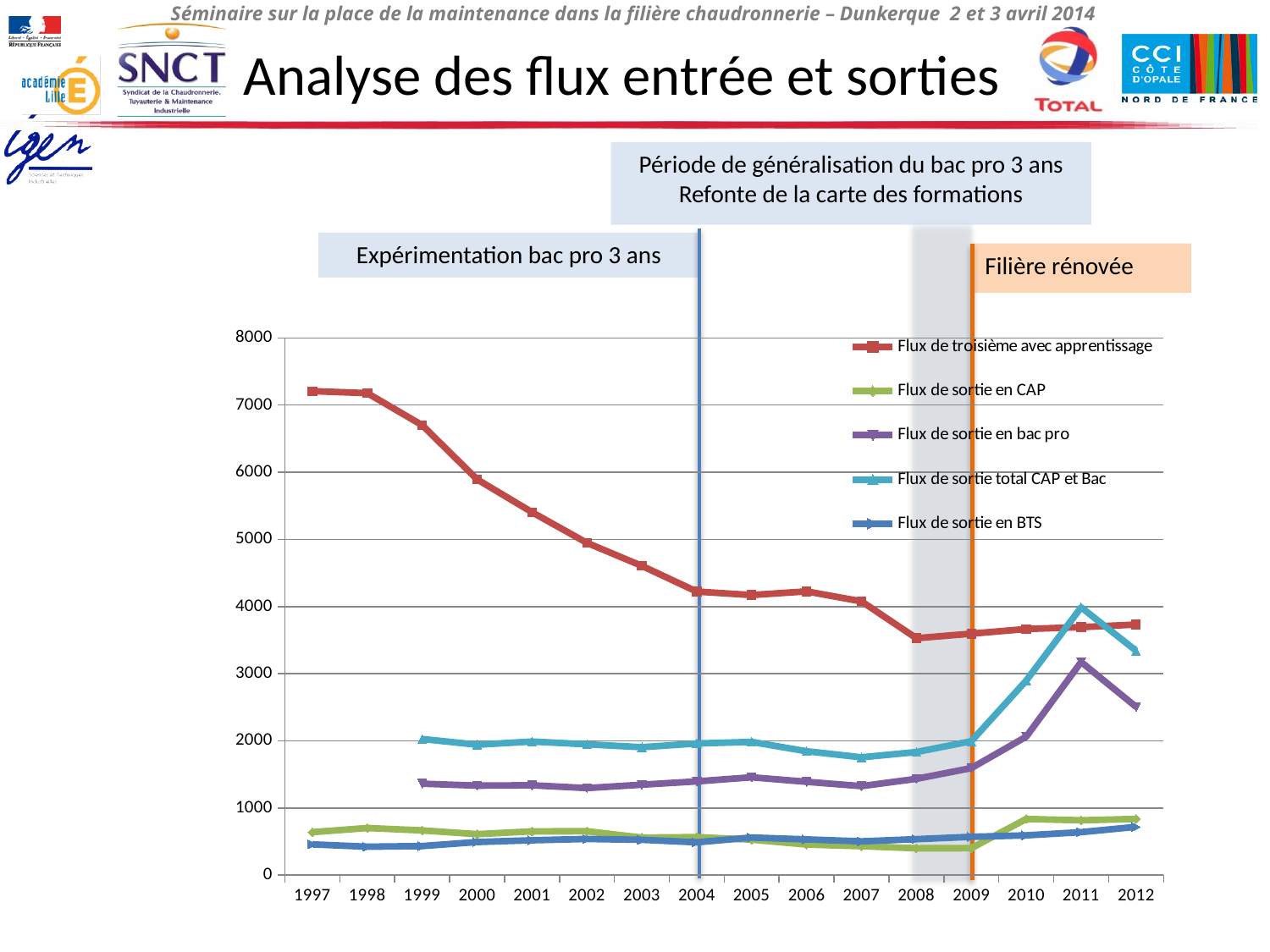
What kind of chart is shown on the slide? line chart Which series has the lowest value in 2008? Flux de sortie en CAP Which series has the highest values across all years? Flux de troisième avec apprentissage Is the value for Flux de troisième avec apprentissage in 2008 greater or less than 4000? less Which series is drawn in red? Flux de troisième avec apprentissage Is the value for Flux de sortie en CAP in 2010 greater or less than 1000? less How many series does the legend list? 5 In 2011, which is larger: Flux de sortie total CAP et Bac or Flux de sortie en bac pro? Flux de sortie total CAP et Bac Does Flux de troisième avec apprentissage rise or fall from 1997 to 2008? fall Is the value for Flux de troisième avec apprentissage in 1997 greater or less than 7000? greater How many years are shown on the x axis? 16